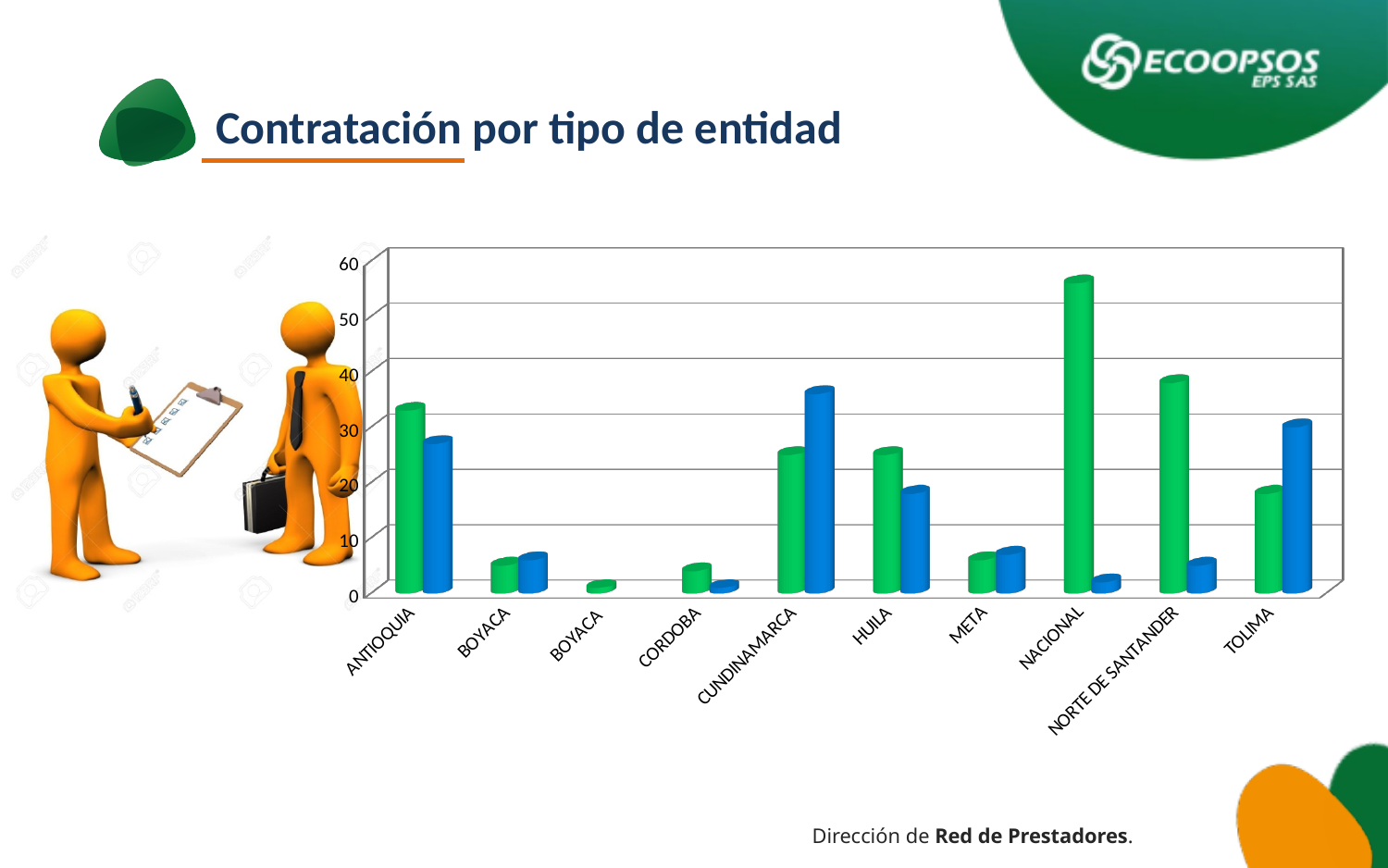
Is the green bar for NACIONAL greater or less than 50? greater What is the title of the slide containing the chart? Contratación por tipo de entidad How many categories are shown along the x axis of the chart? 10 Is the blue bar for NACIONAL greater or less than 10? less Which is larger, the green bar for ANTIOQUIA or the green bar for CUNDINAMARCA? ANTIOQUIA What kind of chart is shown on the slide? bar chart Which category has the tallest bar in the chart? NACIONAL Is the green bar for ANTIOQUIA greater or less than 30? greater For NACIONAL, which bar is larger, the green one or the blue one? green What two colours are used for the bars in the chart? green and blue